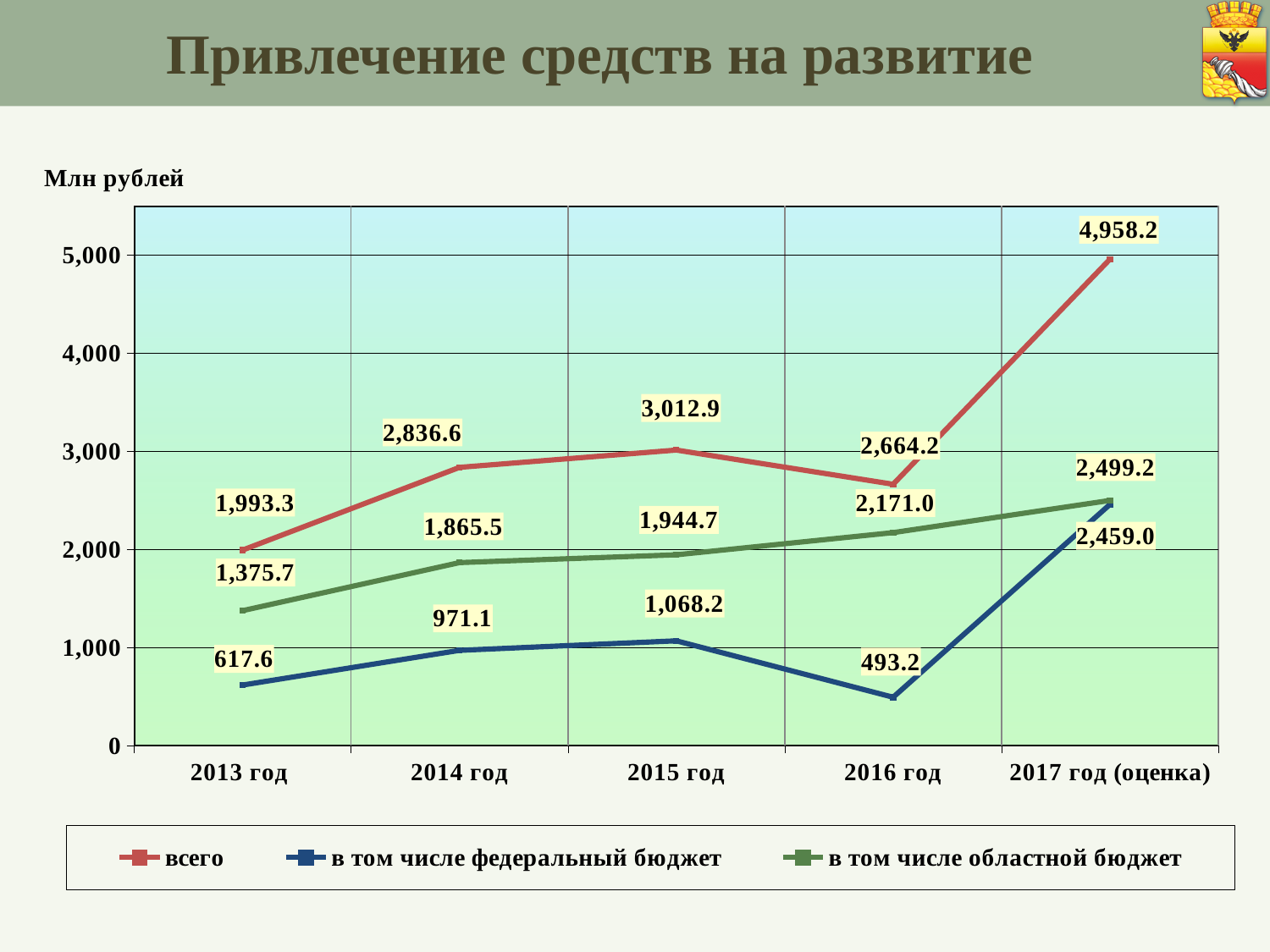
What type of chart is shown on the slide? line chart Which is larger in 2015 год: 'в том числе федеральный бюджет' or 'в том числе областной бюджет'? в том числе областной бюджет What unit is stated above the chart? Млн рублей What is the value of 'в том числе федеральный бюджет' for 2016 год? 493.2 In which year is the 'в том числе федеральный бюджет' series highest? 2017 год (оценка) How many years are shown on the x axis? 5 How many series does the legend list? 3 In which year is the 'всего' series lowest? 2013 год Does the 'в том числе областной бюджет' series rise or fall from 2013 год to 2017 год (оценка)? rise What is the value of 'в том числе областной бюджет' for 2014 год? 1,865.5 What is the value of 'всего' for 2017 год (оценка)? 4,958.2 What is the difference between 'всего' in 2017 год (оценка) and 2016 год? 2,294.0